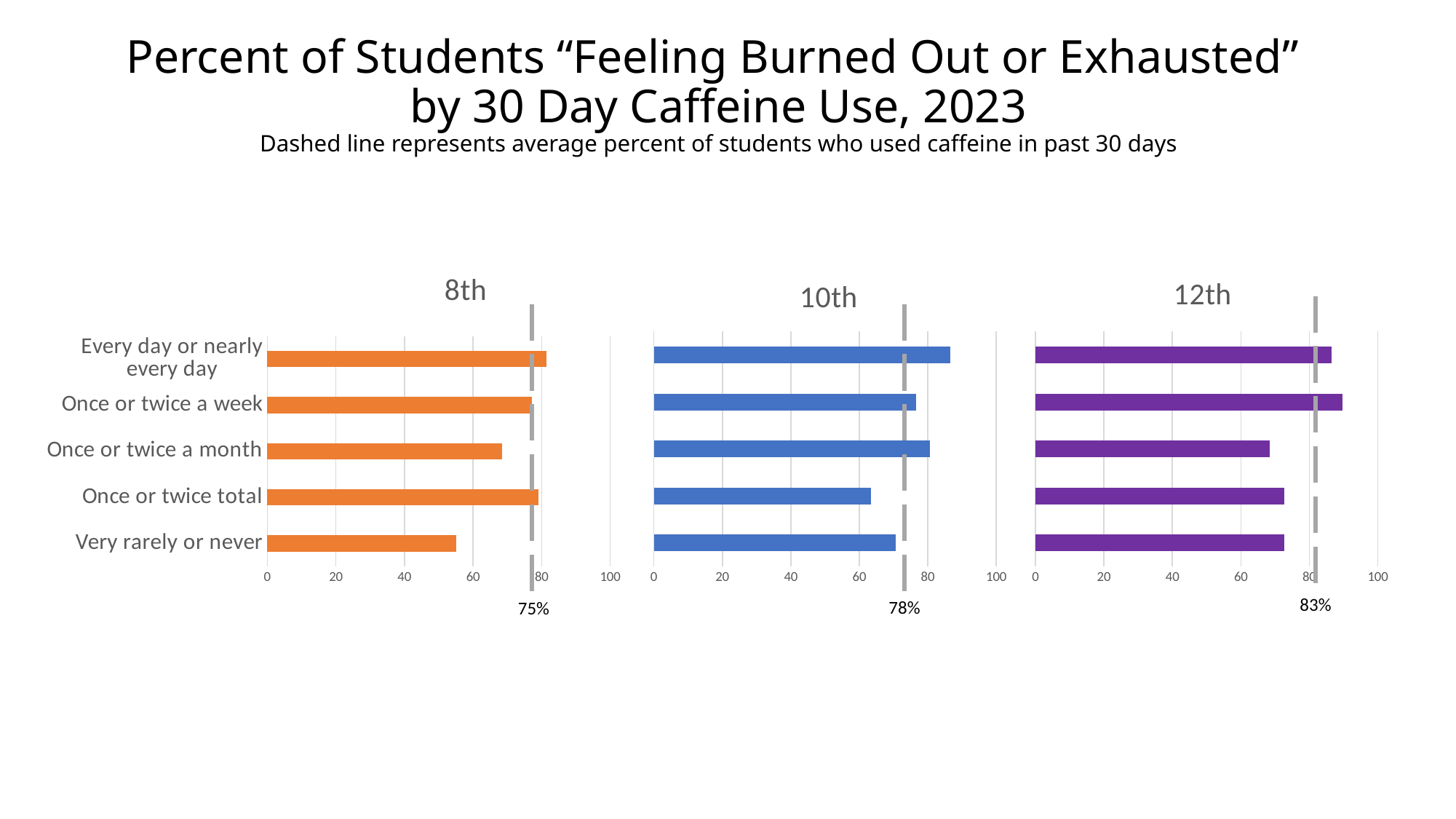
What average percent does the dashed line mark in the 8th grade chart? 75% In the 10th grade chart, which category has the lowest percent of students feeling burned out? Once or twice total What kind of chart is used for the 8th grade panel? bar chart What average percent does the dashed line mark in the 12th grade chart? 83% In the 12th grade chart, is the value for Once or twice a week greater or less than 80? greater In the 12th grade chart, which is larger: the value for Once or twice a week or the value for Once or twice a month? Once or twice a week How many caffeine-use categories are shown in the 10th grade chart? 5 In the 12th grade chart, is the value for Once or twice a month greater or less than 80? less In the 8th grade chart, is the value for Very rarely or never greater or less than 60? less In the 10th grade chart, which category has the highest percent of students feeling burned out? Every day or nearly every day In the 8th grade chart, which category has the lowest percent of students feeling burned out? Very rarely or never